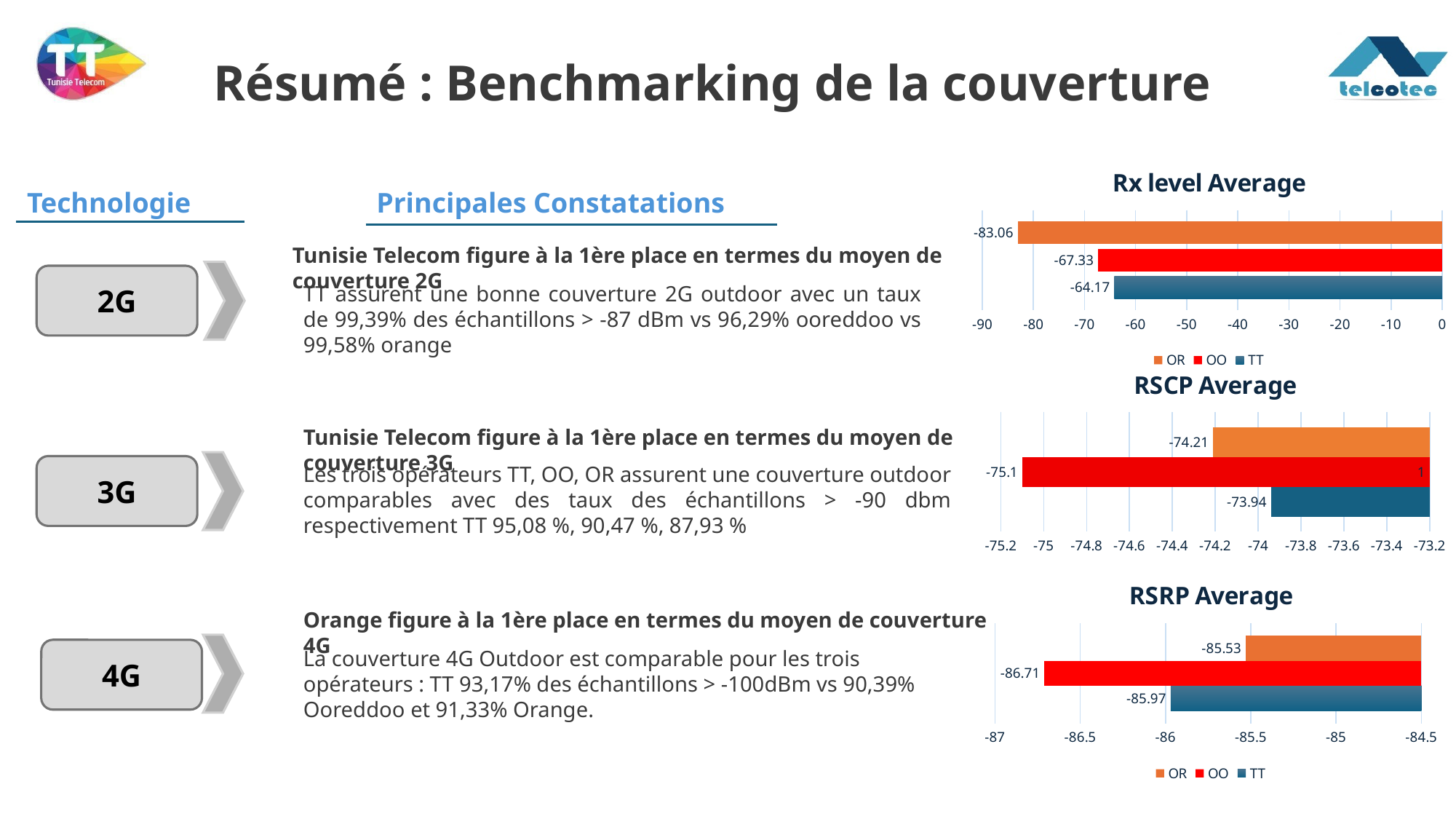
In the Rx level Average chart, which operator has the lowest (most negative) value? OR In the RSCP Average chart, what is the value for OO? -75.1 In the RSRP Average chart, what is the value for TT? -85.97 In the Rx level Average chart, what is the difference between the OO value and the TT value? 3.16 In the RSCP Average chart, which is larger, the value for OR or the value for OO? OR What kind of chart is the Rx level Average chart? Bar chart In the Rx level Average chart, what is the value for TT? -64.17 In the Rx level Average chart, what is the value for OR? -83.06 In the RSCP Average chart, which operator has the highest (least negative) value? TT How many series does the legend of the RSRP Average chart list? 3 In the RSRP Average chart, what is the value for OR? -85.53 In the RSRP Average chart, what is the difference between the OR value and the OO value? 1.18